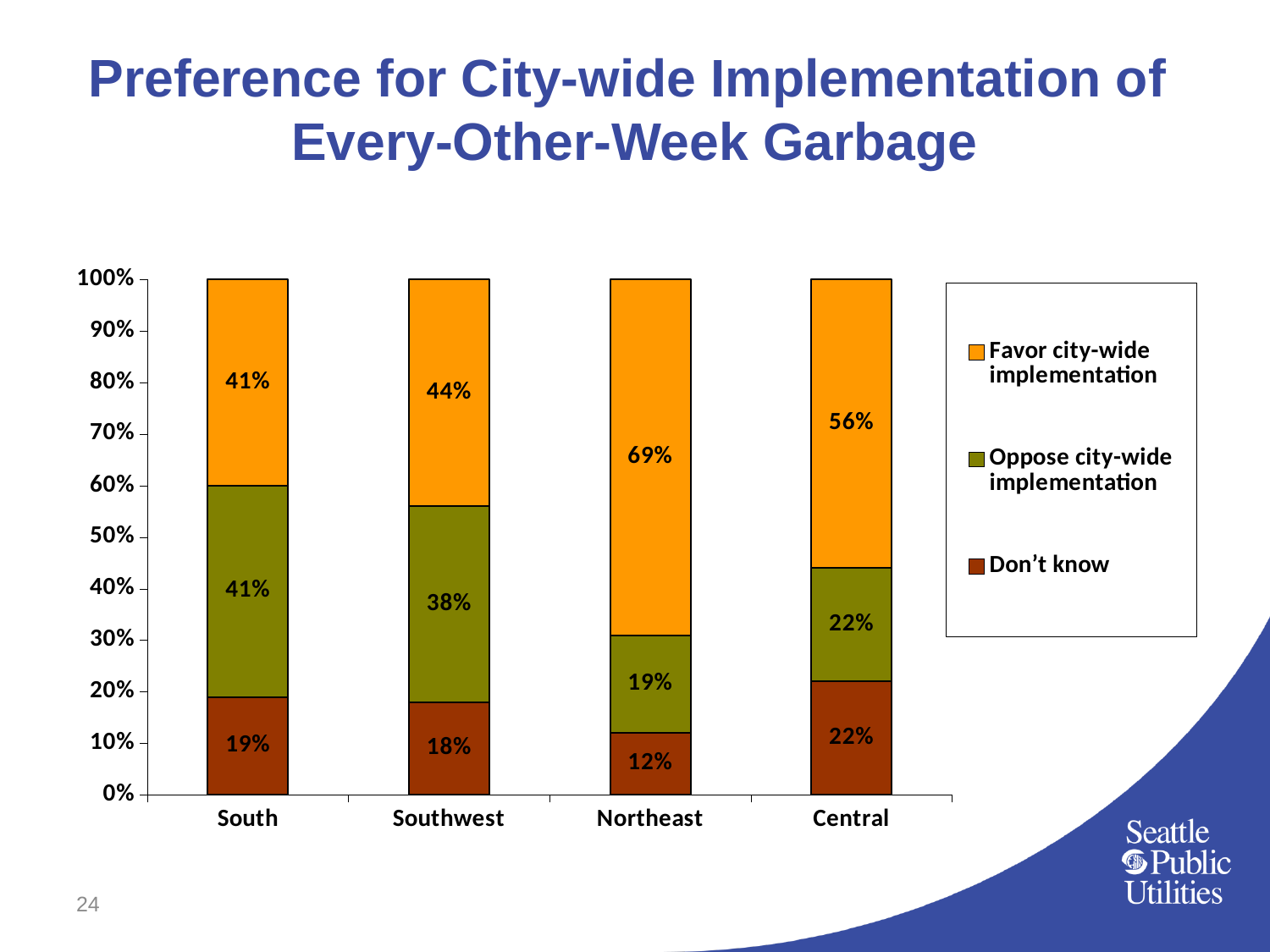
What is the 'Don't know' value for Southwest? 18% Which region has the highest share favoring city-wide implementation? Northeast What percentage of Northeast respondents favor city-wide implementation? 69% What kind of chart is shown on the slide? Stacked bar chart What is the total of the 'Favor' and 'Oppose' segments for Central? 78% Which colour represents 'Don't know' in the legend? Dark red/brown What is the difference between the 'Favor city-wide implementation' values for Northeast and South? 28% Which region has the lowest 'Don't know' share? Northeast Which is larger: the 'Oppose city-wide implementation' value for South or for Southwest? South How many series does the legend list? 3 What percentage of Central respondents oppose city-wide implementation? 22% How many regions are shown on the x axis? 4